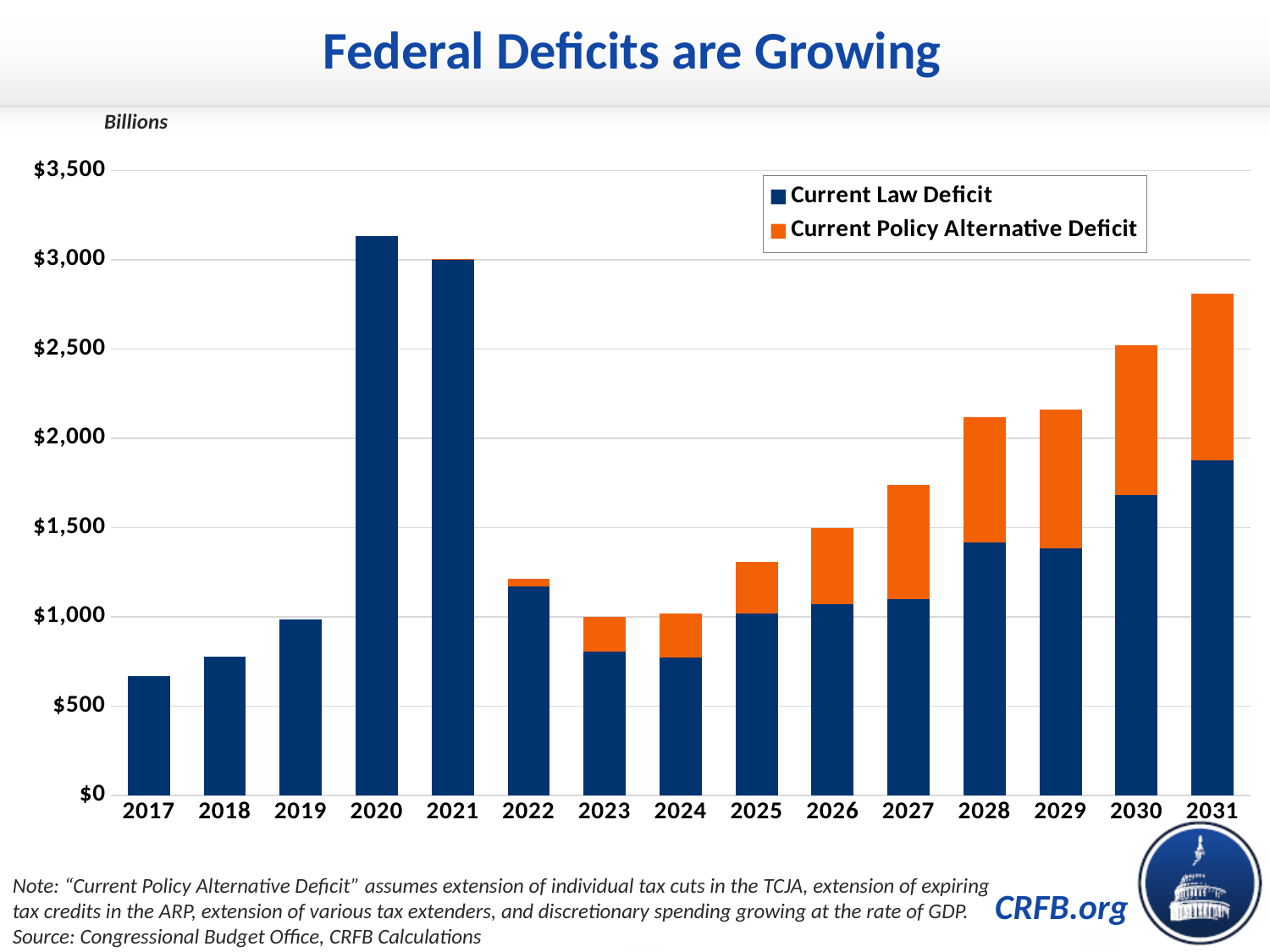
Which year has the larger total deficit bar, 2030 or 2031? 2031 What kind of chart is shown on the slide? Bar chart How many years are shown on the x axis? 15 Is the Current Law Deficit for 2023 greater or less than $1,000 billion? less What is the title of the chart? Federal Deficits are Growing Which year has the highest total deficit bar? 2020 How many series does the legend list? 2 Is the deficit for 2020 greater or less than $3,000 billion? greater Which year has the lowest deficit bar? 2017 Is the deficit for 2017 greater or less than $1,000 billion? less Do the total deficit bars rise or fall from 2023 to 2031? rise